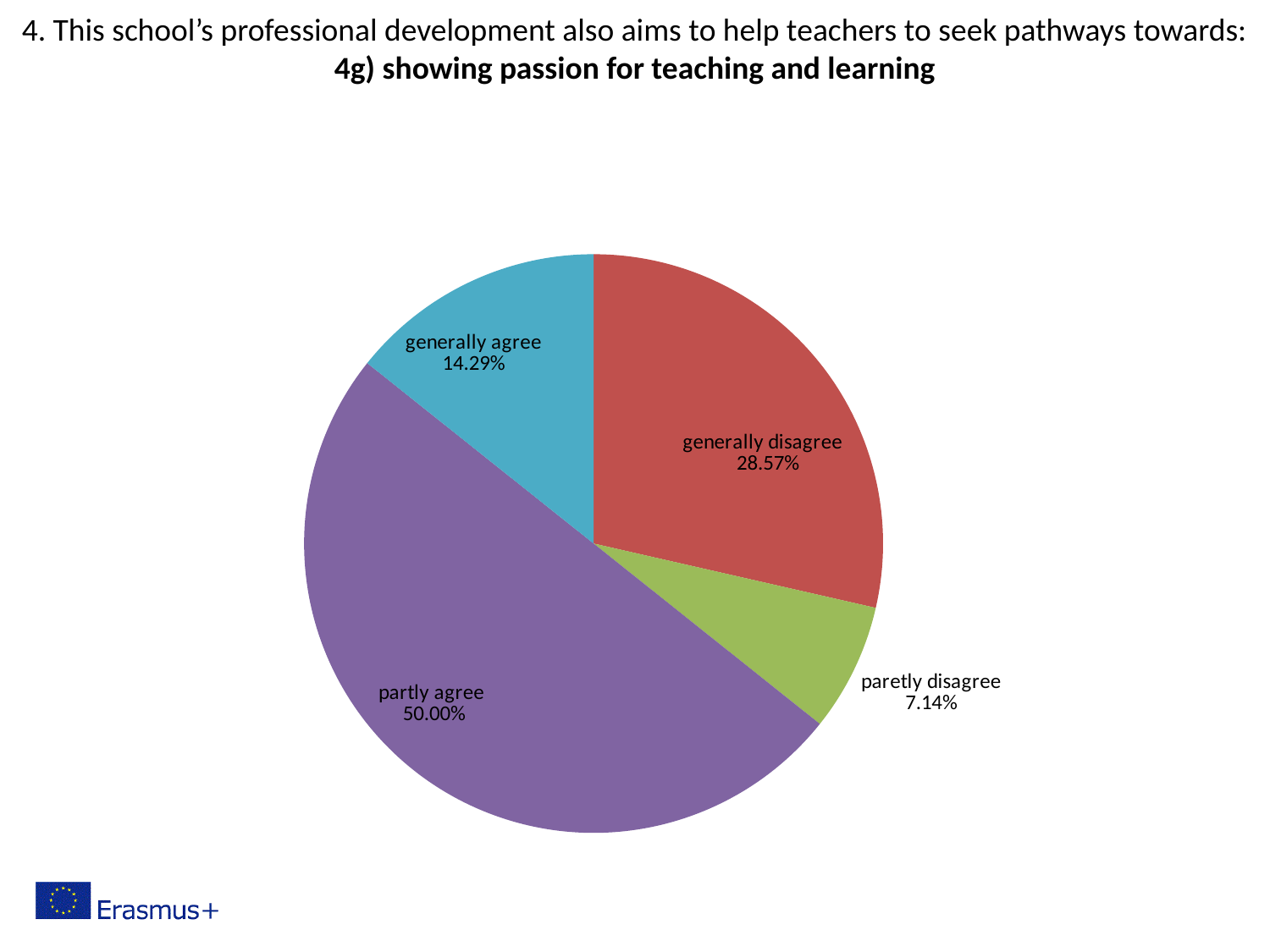
How many slices does the pie chart have? 4 What kind of chart is shown on the slide? pie chart What percentage of respondents chose 'generally disagree'? 28.57% What percentage of respondents chose 'paretly disagree'? 7.14% Which response category has the largest share of the pie? partly agree What is the combined share of 'generally agree' and 'partly agree'? 64.29% What percentage of respondents chose 'generally agree'? 14.29% What colour is the 'partly agree' slice? purple What is the difference in percentage points between 'generally disagree' and 'generally agree'? 14.28 Which is larger: the share for 'generally disagree' or the share for 'generally agree'? generally disagree What percentage of respondents chose 'partly agree'? 50.00% Which response category has the smallest share of the pie? paretly disagree